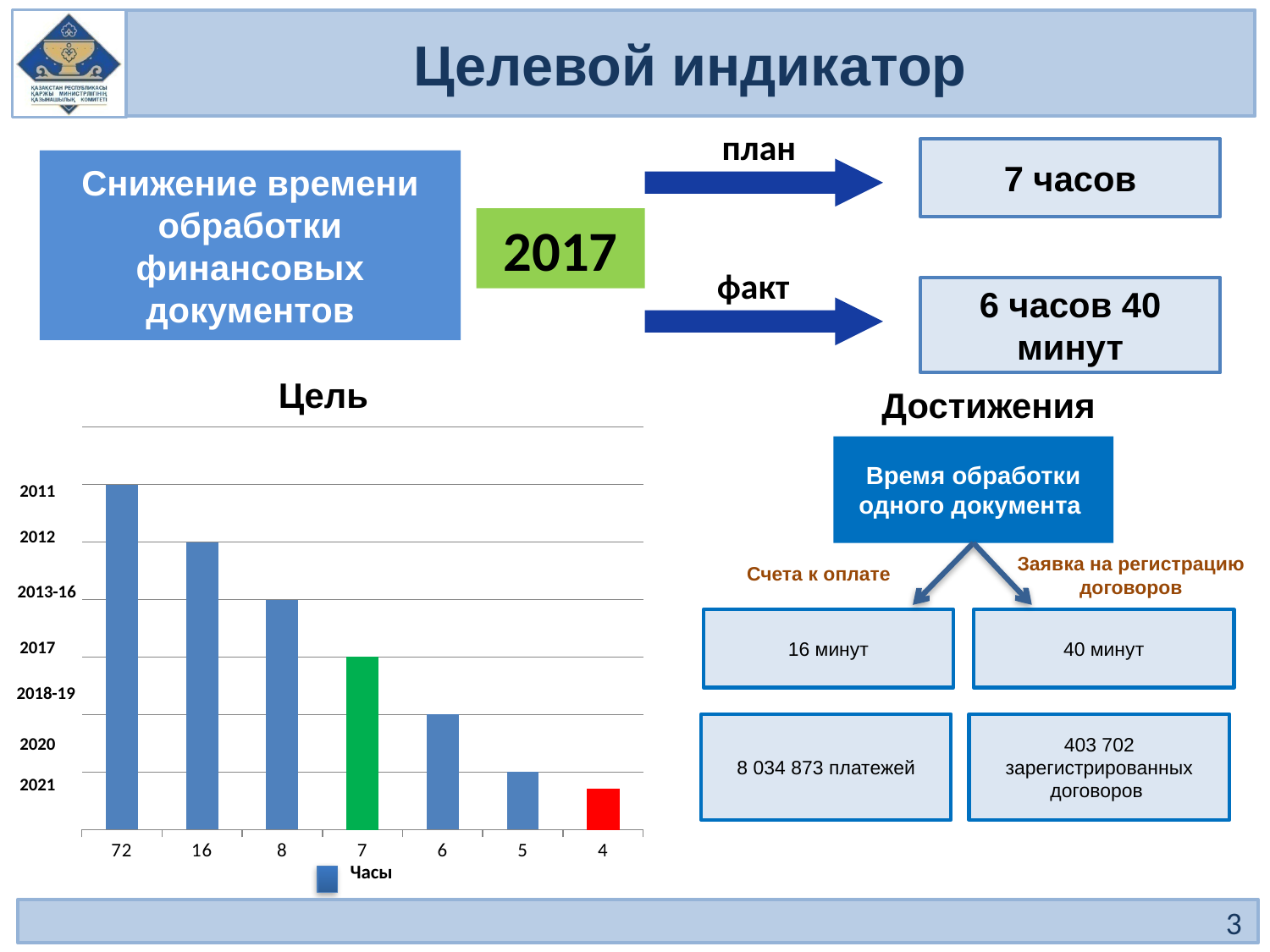
What kind of chart is the chart titled "Цель"? bar chart How many bars are plotted in the "Цель" chart? 7 What is the legend entry of the "Цель" chart? Часы How many series does the legend of the "Цель" chart list? 1 In the "Цель" chart, which y-axis label does the bar for category 72 reach? 2011 In the "Цель" chart, which y-axis label does the bar for category 7 reach? 2017 In the "Цель" chart, which x-axis category has the shortest bar? 4 In the "Цель" chart, which x-axis category has the tallest bar? 72 In the "Цель" chart, what colour is the bar for category 7? green In the "Цель" chart, which y-axis label does the bar for category 4 reach? 2021 In the "Цель" chart, which bar is taller: the one for category 16 or the one for category 8? 16 In the "Цель" chart, do the bars rise or fall from left to right along the x axis? fall